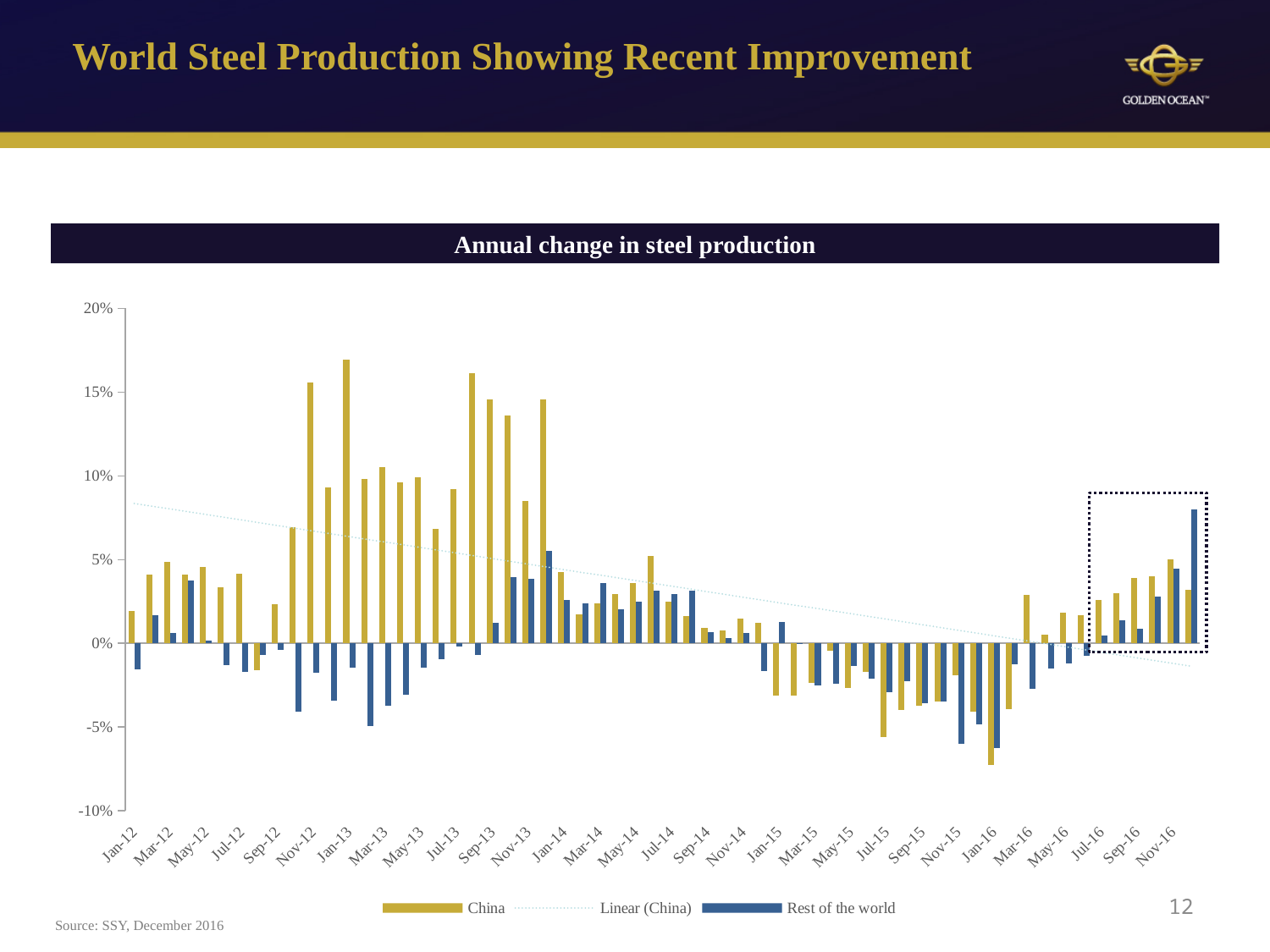
Is the value for Rest of the world in Nov-16 greater or less than 5%? less Is the value for China in Jan-13 greater or less than 15%? greater In Nov-16, which is larger: the value for China or for Rest of the world? China Which month has the lowest value for China? Jan-16 Is the value for China in Jan-16 greater or less than -5%? less Which month has the highest value for China? Jan-13 Which month has the highest value for Rest of the world? Dec-16 Does the Linear (China) trend line rise or fall from left to right across the x axis? Falls How many month labels are shown on the x axis? 30 How many entries does the chart legend list? 3 What kind of chart is shown on the slide? Bar chart What is the title of the chart? Annual change in steel production